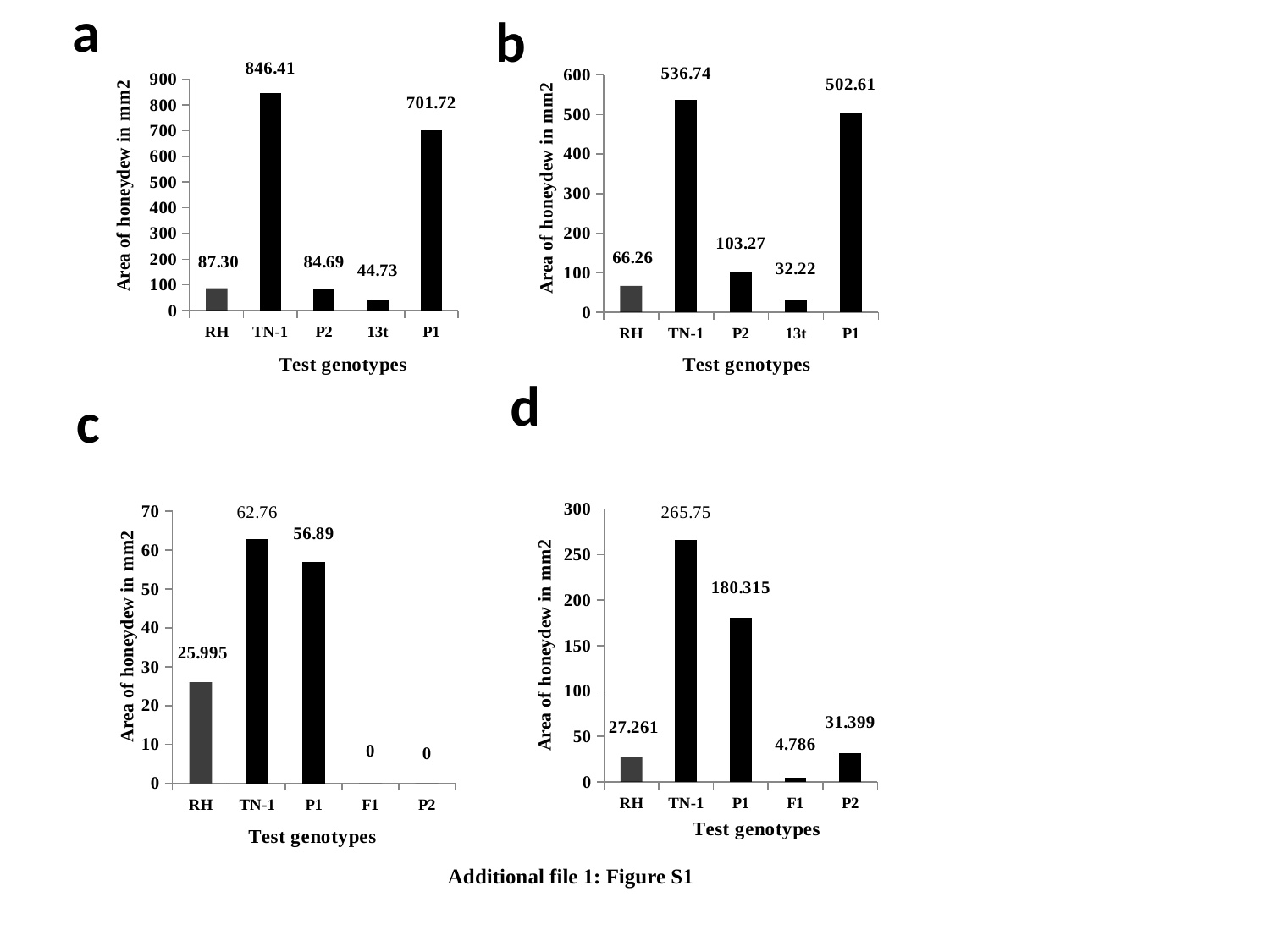
In chart a (top left), which test genotype has the lowest area of honeydew? 13t In chart b (top right), which test genotype has the highest area of honeydew? TN-1 In chart b (top right), what is the difference between the values for TN-1 and P1? 34.13 What is the y-axis label of chart a (top left)? Area of honeydew in mm2 What kind of chart is chart d (bottom right)? Bar chart In chart b (top right), what is the area of honeydew for P2? 103.27 In chart a (top left), what is the area of honeydew for TN-1? 846.41 In chart d (bottom right), what is the area of honeydew for F1? 4.786 In chart c (bottom left), which is larger, the value for TN-1 or the value for P1? TN-1 In chart c (bottom left), how many test genotypes are shown on the x axis? 5 In chart d (bottom right), which test genotype has the lowest area of honeydew? F1 In chart c (bottom left), what is the area of honeydew for RH? 25.995